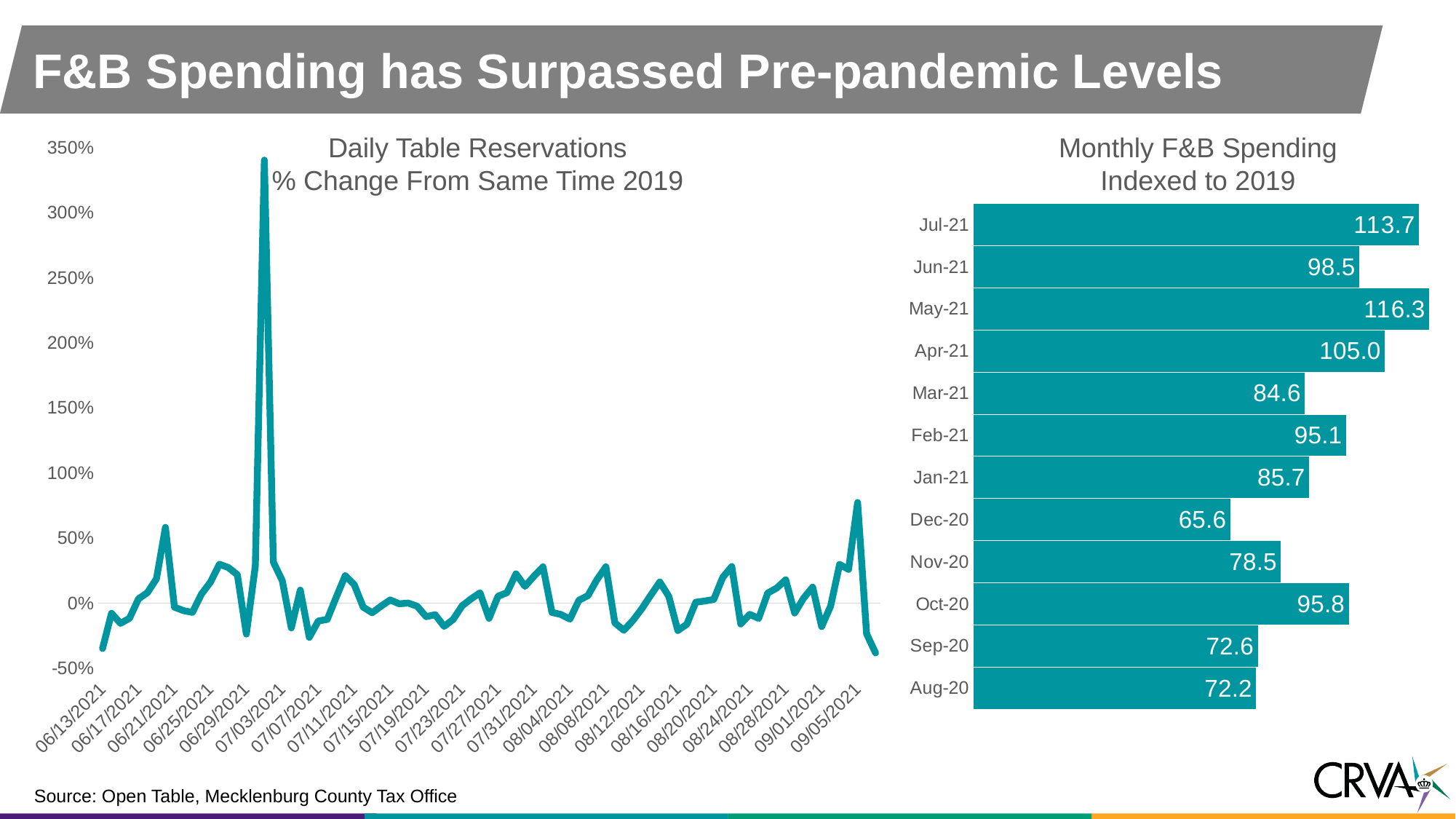
In the Monthly F&B Spending Indexed to 2019 chart, which is larger, the value for Oct-20 or the value for Nov-20? Oct-20 In the Daily Table Reservations chart, is the peak value near 07/03/2021 greater or less than 300%? greater How many months are shown in the Monthly F&B Spending Indexed to 2019 chart? 12 In the Monthly F&B Spending Indexed to 2019 chart, what is the value for Dec-20? 65.6 In the Daily Table Reservations chart, is the value at the first date, 06/13/2021, greater or less than 0%? less What kind of chart is the Monthly F&B Spending Indexed to 2019 chart? bar chart What kind of chart is the Daily Table Reservations % Change From Same Time 2019 chart? line chart In the Monthly F&B Spending Indexed to 2019 chart, which month has the lowest value? Dec-20 In the Monthly F&B Spending Indexed to 2019 chart, what is the difference between the values for Sep-20 and Aug-20? 0.4 In the Monthly F&B Spending Indexed to 2019 chart, what is the difference between the values for May-21 and Jun-21? 17.8 In the Monthly F&B Spending Indexed to 2019 chart, which month has the highest value? May-21 In the Monthly F&B Spending Indexed to 2019 chart, what is the value for Jul-21? 113.7